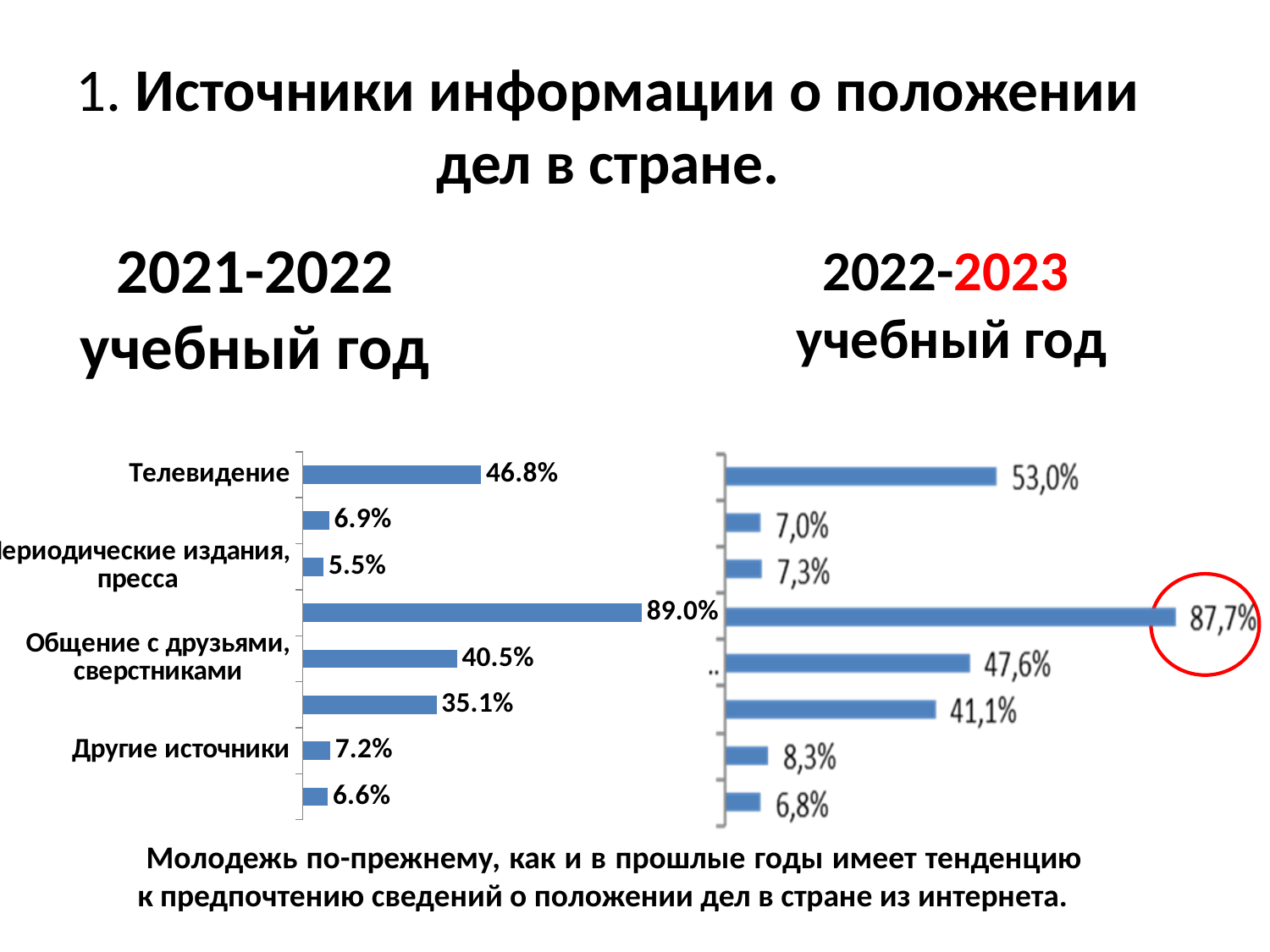
On the right chart (2022-2023 учебный год), what is the smallest value shown? 6,8% On the left chart (2021-2022 учебный год), what is the value for Периодические издания, пресса? 5.5% How many bars does the right chart (2022-2023 учебный год) contain? 8 On the right chart (2022-2023 учебный год), what is the largest value shown? 87,7% On the left chart (2021-2022 учебный год), what is the value for Другие источники? 7.2% On the left chart (2021-2022 учебный год), what is the largest value shown? 89.0% On the left chart (2021-2022 учебный год), what is the difference between the values for Телевидение and Общение с друзьями, сверстниками? 6.3% On the left chart (2021-2022 учебный год), what is the value for Телевидение? 46.8% On the left chart (2021-2022 учебный год), which is larger: the value for Телевидение or the value for Другие источники? Телевидение On the left chart (2021-2022 учебный год), what is the value for Общение с друзьями, сверстниками? 40.5% What type of chart is used on the left side of the slide (2021-2022 учебный год)? Bar chart On the left chart (2021-2022 учебный год), which labelled category has the lowest value? Периодические издания, пресса